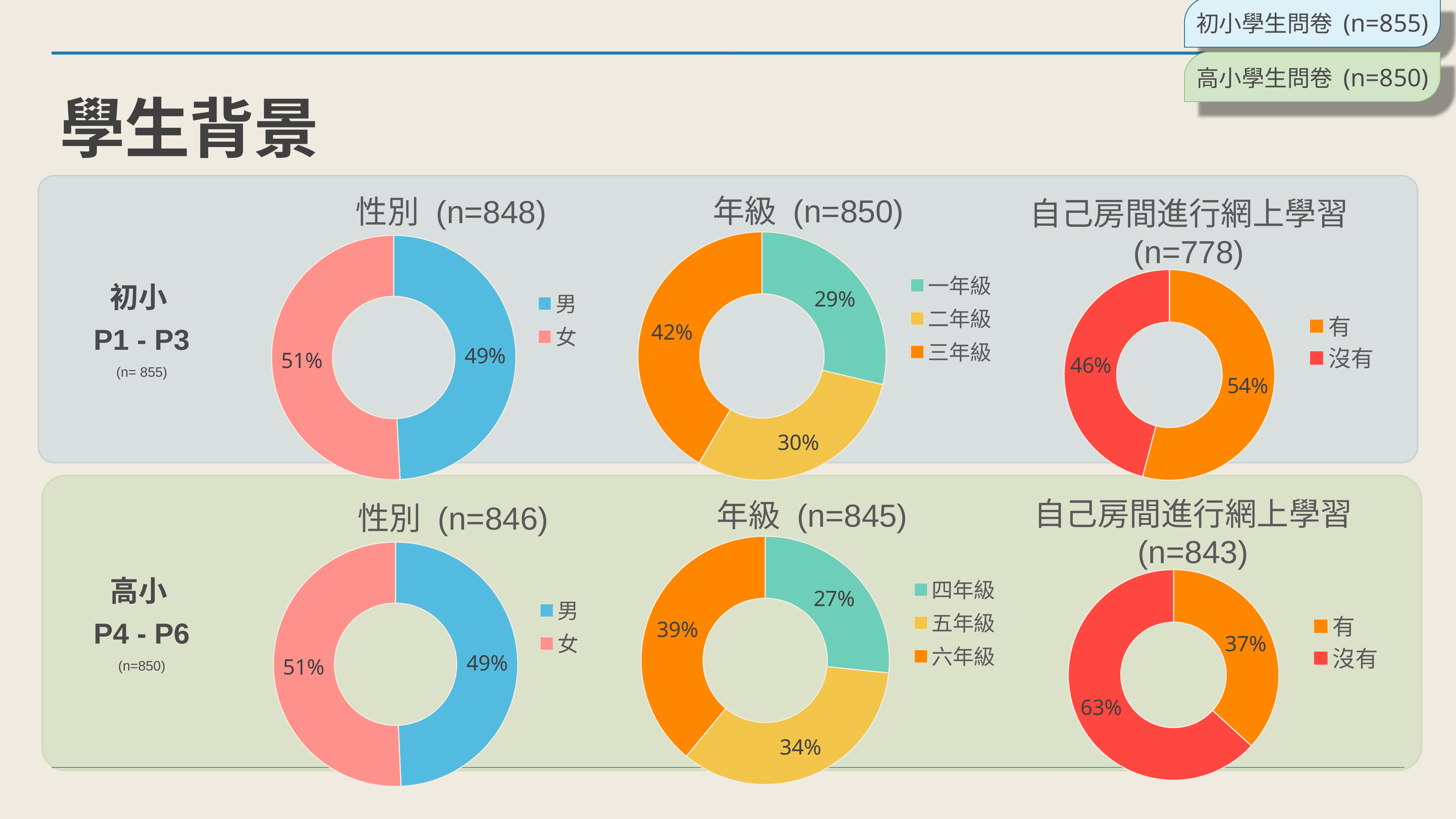
In the top-row 自己房間進行網上學習 (n=778) chart, what percentage answered 有? 54% What is the title of the middle chart in the top row? 年級 (n=850) In the bottom-row 年級 (n=845) chart, what percentage is 五年級? 34% What kind of chart is the bottom-row 性別 (n=846) chart? Doughnut chart In the bottom-row 自己房間進行網上學習 (n=843) chart, what is the difference between 沒有 and 有? 26% In the bottom-row 年級 (n=845) chart, which grade has the largest share? 六年級 In the top-row 性別 (n=848) chart, which is larger, 男 or 女? 女 In the top-row 年級 (n=850) chart, what percentage is 三年級? 42% In the top-row 年級 (n=850) chart, which grade has the smallest share? 一年級 In the bottom-row 自己房間進行網上學習 (n=843) chart, what percentage answered 沒有? 63% How many categories does the bottom-row 年級 (n=845) chart show? 3 How many series does the legend of the top-row 自己房間進行網上學習 (n=778) chart list? 2